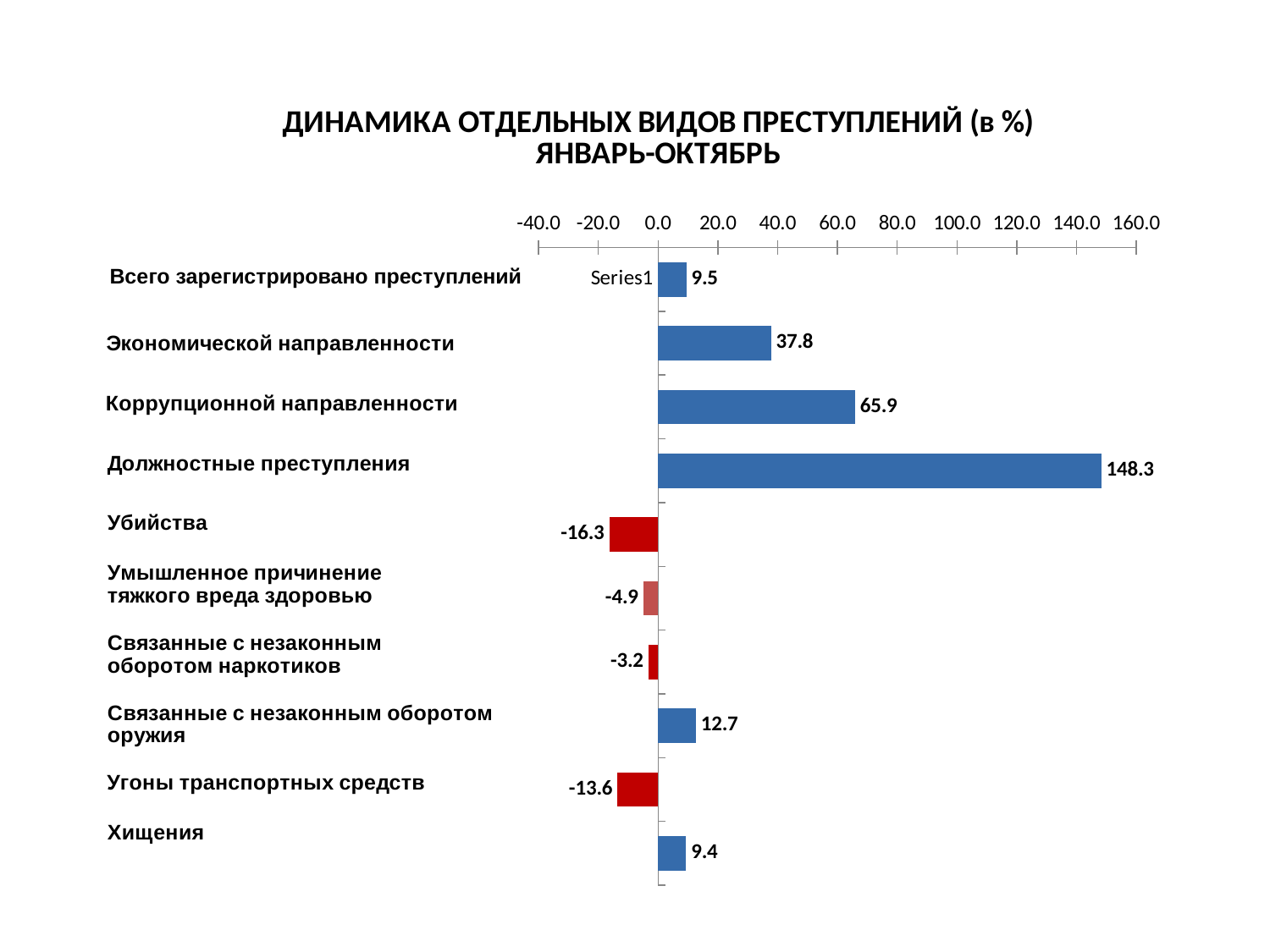
Is the value for Должностные преступления greater or less than 140.0? greater Which is larger, the value for Экономической направленности or the value for Связанные с незаконным оборотом оружия? Экономической направленности What is the difference between the values for Коррупционной направленности and Экономической направленности? 28.1 Which category has the lowest value? Убийства Which category has the highest value? Должностные преступления What is the value for Коррупционной направленности? 65.9 What kind of chart is shown on the slide? bar chart How many categories are shown in the chart? 10 What is the title of the chart? ДИНАМИКА ОТДЕЛЬНЫХ ВИДОВ ПРЕСТУПЛЕНИЙ (в %) ЯНВАРЬ-ОКТЯБРЬ What is the value for Связанные с незаконным оборотом оружия? 12.7 What is the value for Угоны транспортных средств? -13.6 What is the value for Должностные преступления? 148.3